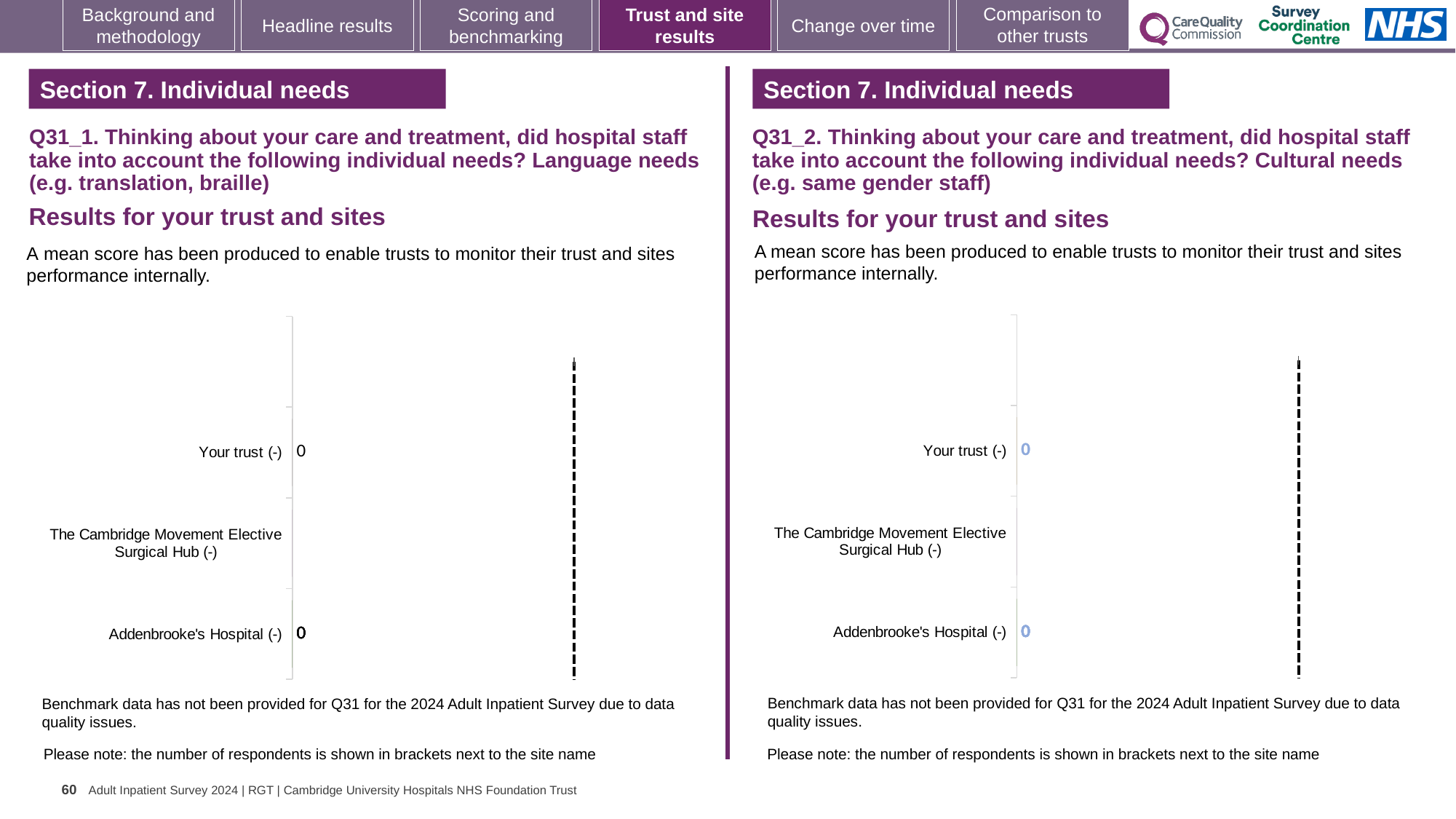
How many categories are listed on the vertical axis of the left chart (Q31_1, Language needs)? 3 In the right chart (Q31_2, Cultural needs), what value is shown for Addenbrooke's Hospital? 0 In the right chart (Q31_2, Cultural needs), what is the difference between the values for Your trust and Addenbrooke's Hospital? 0 According to the note below the right chart (Q31_2, Cultural needs), why has benchmark data not been provided for Q31? Due to data quality issues How many categories are listed on the vertical axis of the right chart (Q31_2, Cultural needs)? 3 In the left chart (Q31_1, Language needs), what value is shown for Your trust? 0 What is the name of the middle category on the vertical axis of the left chart (Q31_1, Language needs)? The Cambridge Movement Elective Surgical Hub (-) In the left chart (Q31_1, Language needs), what value is shown for Addenbrooke's Hospital? 0 In the right chart (Q31_2, Cultural needs), what value is shown for Your trust? 0 In the left chart (Q31_1, Language needs), what is the difference between the values for Your trust and Addenbrooke's Hospital? 0